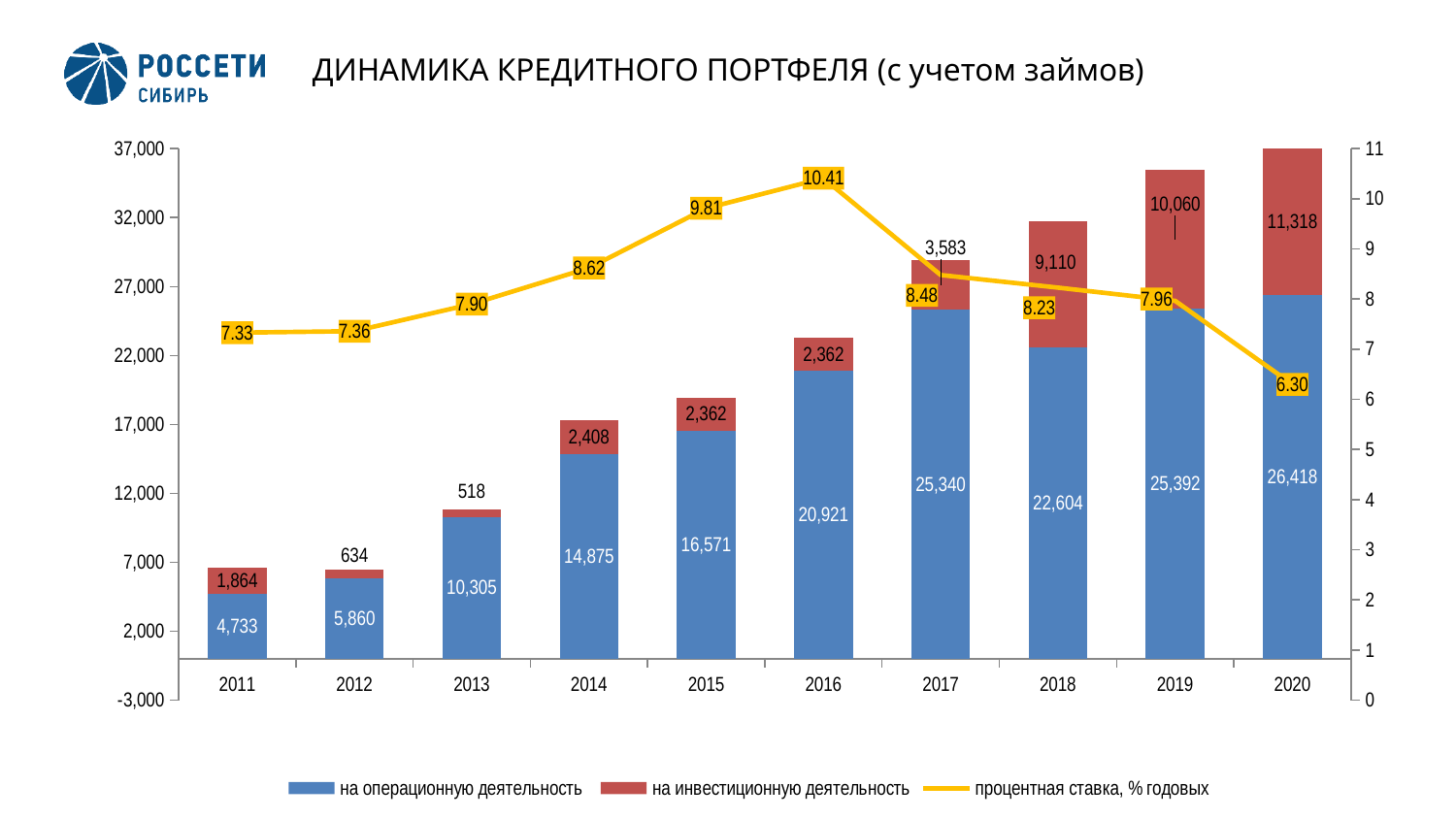
What is the interest rate ('процентная ставка, % годовых') shown for 2014? 8.62 In which year is the interest rate ('процентная ставка, % годовых') highest? 2016 How many series does the legend list? 3 In which year is the value for 'на инвестиционную деятельность' lowest? 2013 What is the value for 'на операционную деятельность' in 2017? 25,340 How many years are shown on the x axis? 10 What is the total of the stacked bar for 2020? 37,736 Which is larger: the 'на операционную деятельность' value for 2017 or for 2018? 2017 What is the value for 'на инвестиционную деятельность' in 2019? 10,060 What kind of chart is shown on the slide? Stacked bar chart with a line What is the difference between the 'на операционную деятельность' values for 2020 and 2019? 1,026 In which year is the interest rate ('процентная ставка, % годовых') lowest? 2020